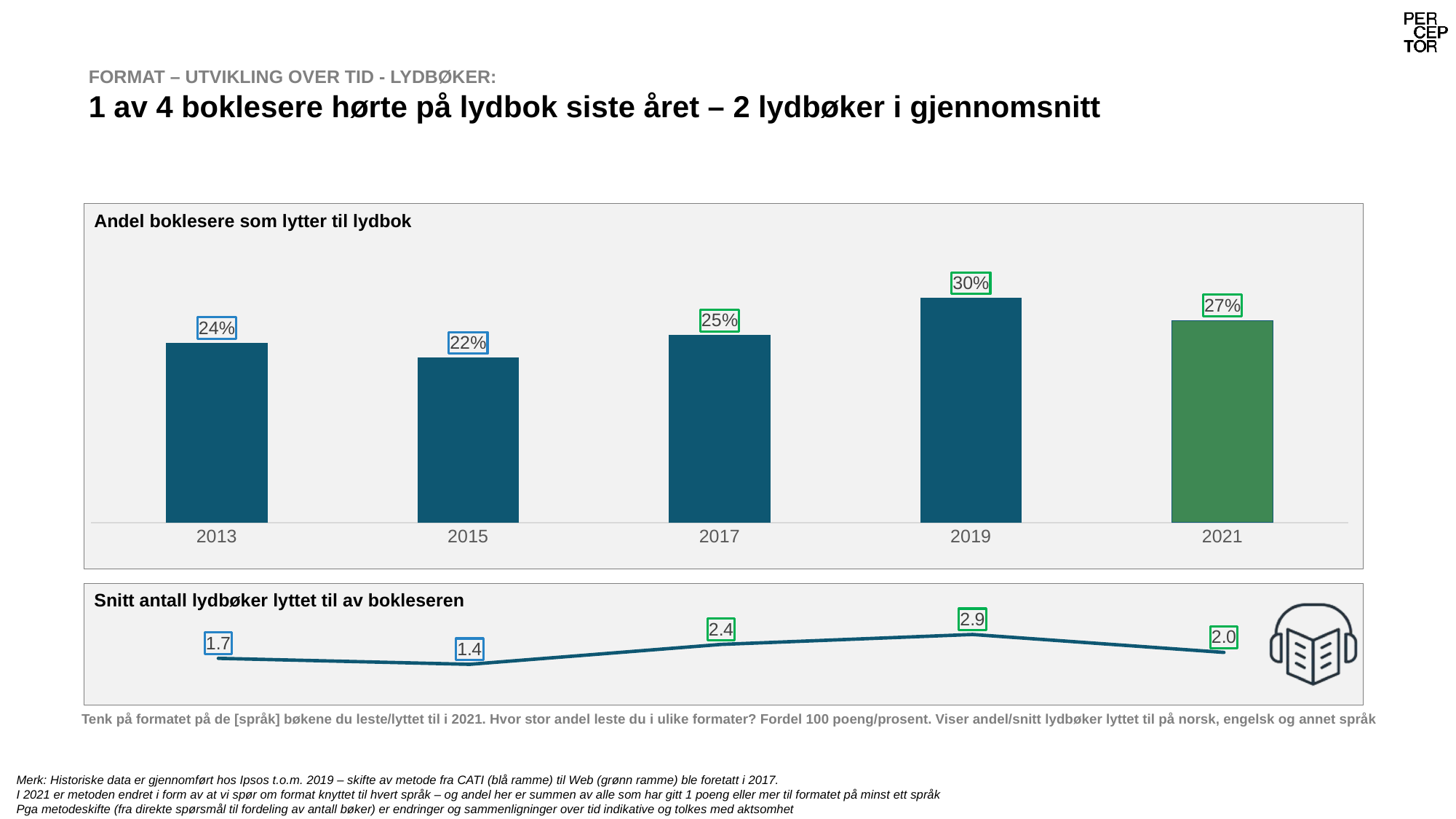
In the chart 'Andel boklesere som lytter til lydbok', what is the difference between the values for 2019 and 2021? 3% What kind of chart is 'Andel boklesere som lytter til lydbok'? Bar chart What kind of chart is 'Snitt antall lydbøker lyttet til av bokleseren'? Line chart In the chart 'Snitt antall lydbøker lyttet til av bokleseren', what is the value for 2021? 2.0 In the chart 'Andel boklesere som lytter til lydbok', how many years are shown? 5 In the chart 'Andel boklesere som lytter til lydbok', which year has the lowest value? 2015 In the chart 'Snitt antall lydbøker lyttet til av bokleseren', which year has the highest value? 2019 In the chart 'Snitt antall lydbøker lyttet til av bokleseren', what is the value for 2017? 2.4 In the chart 'Andel boklesere som lytter til lydbok', what is the value for 2019? 30% In the chart 'Andel boklesere som lytter til lydbok', which year has the highest value? 2019 In the chart 'Snitt antall lydbøker lyttet til av bokleseren', is the value for 2013 larger or smaller than the value for 2015? Larger In the chart 'Andel boklesere som lytter til lydbok', what is the value for 2013? 24%